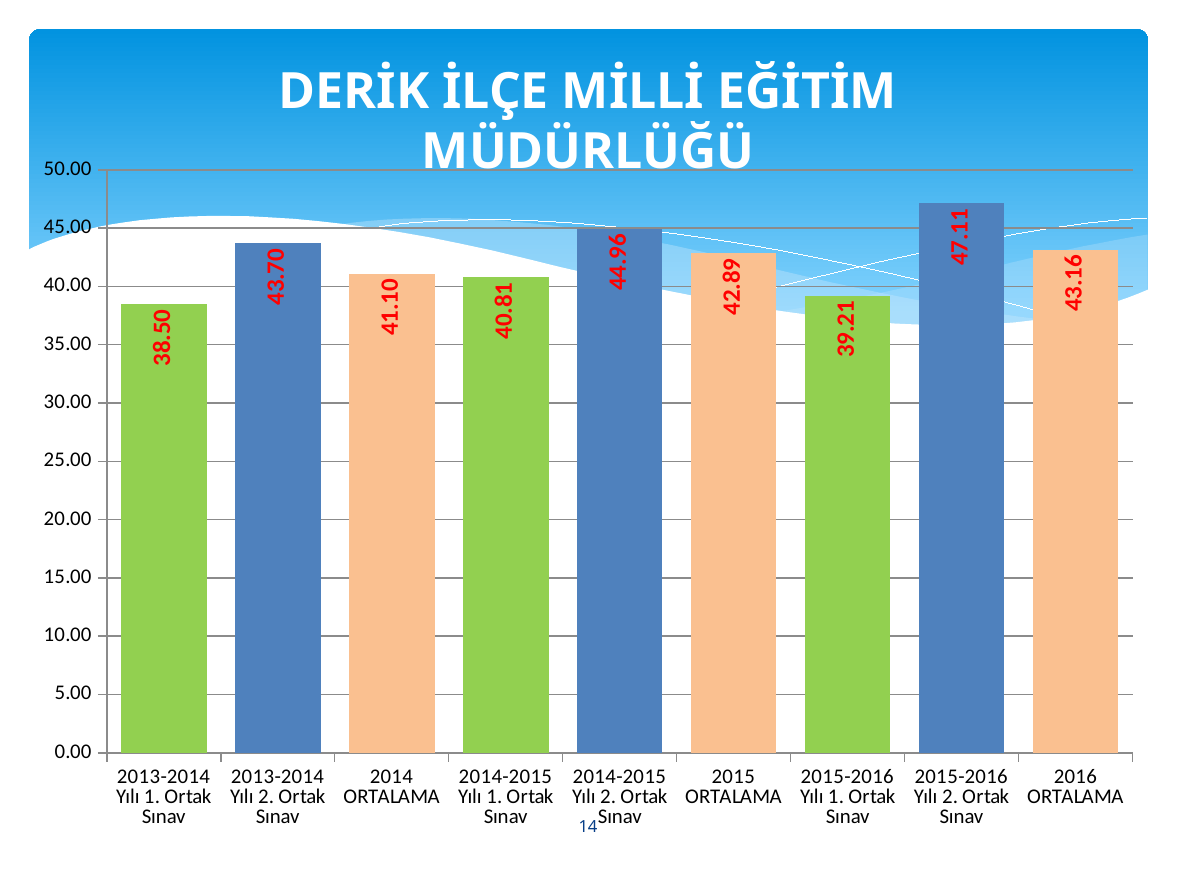
What is the value for 2013-2014 Yılı 1. Ortak Sınav? 38.50 What kind of chart is shown on the slide? bar chart Which category has the lowest value? 2013-2014 Yılı 1. Ortak Sınav What is the value for 2015-2016 Yılı 2. Ortak Sınav? 47.11 What is the value for 2015 ORTALAMA? 42.89 Which category has the highest value? 2015-2016 Yılı 2. Ortak Sınav What is the difference between the values for 2016 ORTALAMA and 2014 ORTALAMA? 2.06 Which is larger, the value for 2014-2015 Yılı 2. Ortak Sınav or the value for 2013-2014 Yılı 2. Ortak Sınav? 2014-2015 Yılı 2. Ortak Sınav How many bars are shown in the chart? 9 What is the title of the chart? DERİK İLÇE MİLLİ EĞİTİM MÜDÜRLÜĞÜ What is the value for 2014-2015 Yılı 1. Ortak Sınav? 40.81 Is the value for 2015-2016 Yılı 1. Ortak Sınav greater or less than 40.00? less